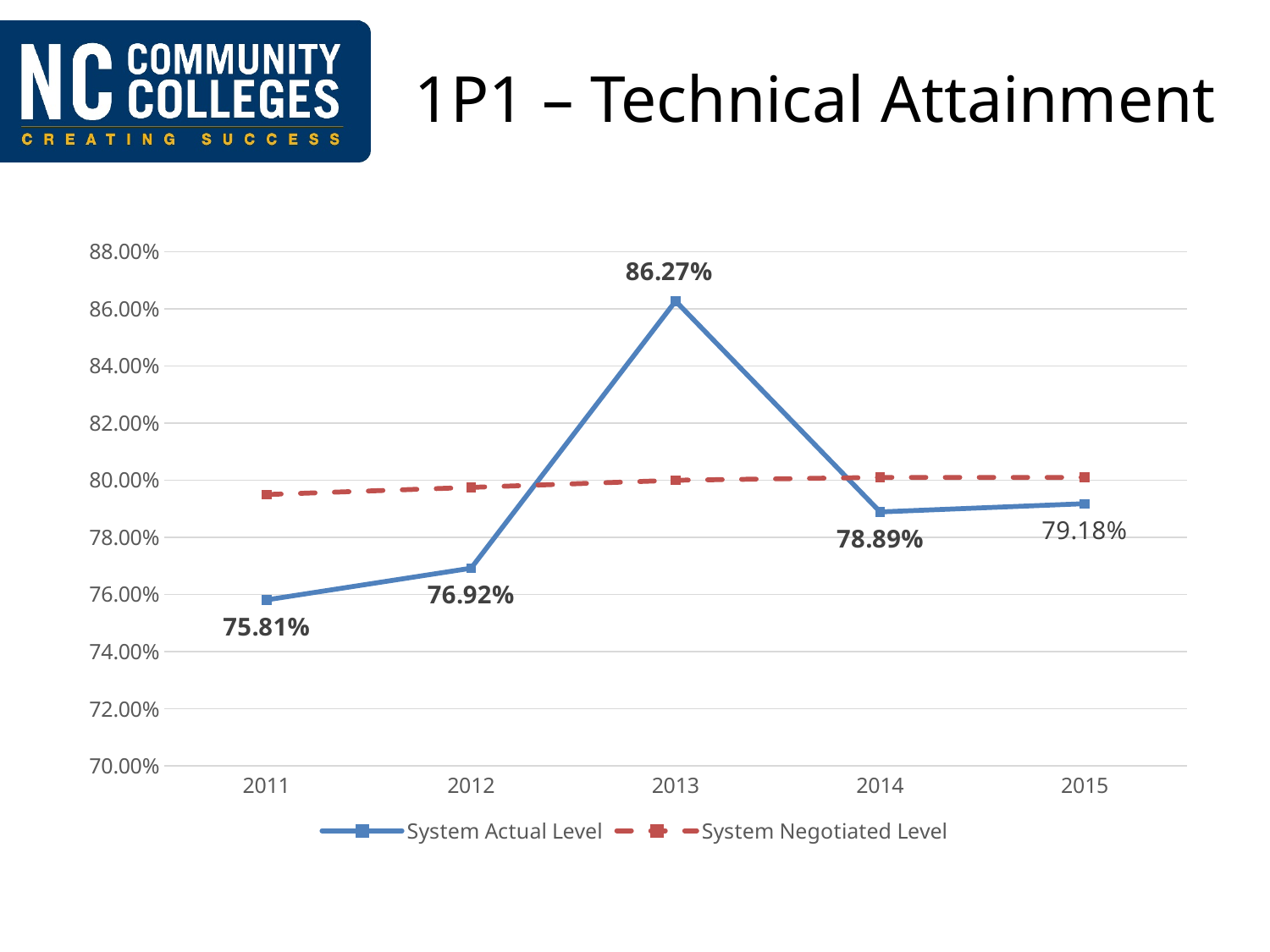
What is the System Actual Level for 2013? 86.27% Is the System Negotiated Level for 2011 greater or less than 80.00%? less What is the System Actual Level for 2015? 79.18% In which year is the System Actual Level lowest? 2011 What kind of chart is shown on the slide? Line chart Is the System Actual Level for 2013 greater or less than 84.00%? greater Which is larger, the System Actual Level in 2012 or in 2015? 2015 In which year is the System Actual Level highest? 2013 What is the System Actual Level for 2011? 75.81% What is the difference between the System Actual Level in 2013 and in 2014? 7.38% How many series does the legend list? 2 How many years are shown on the x axis? 5